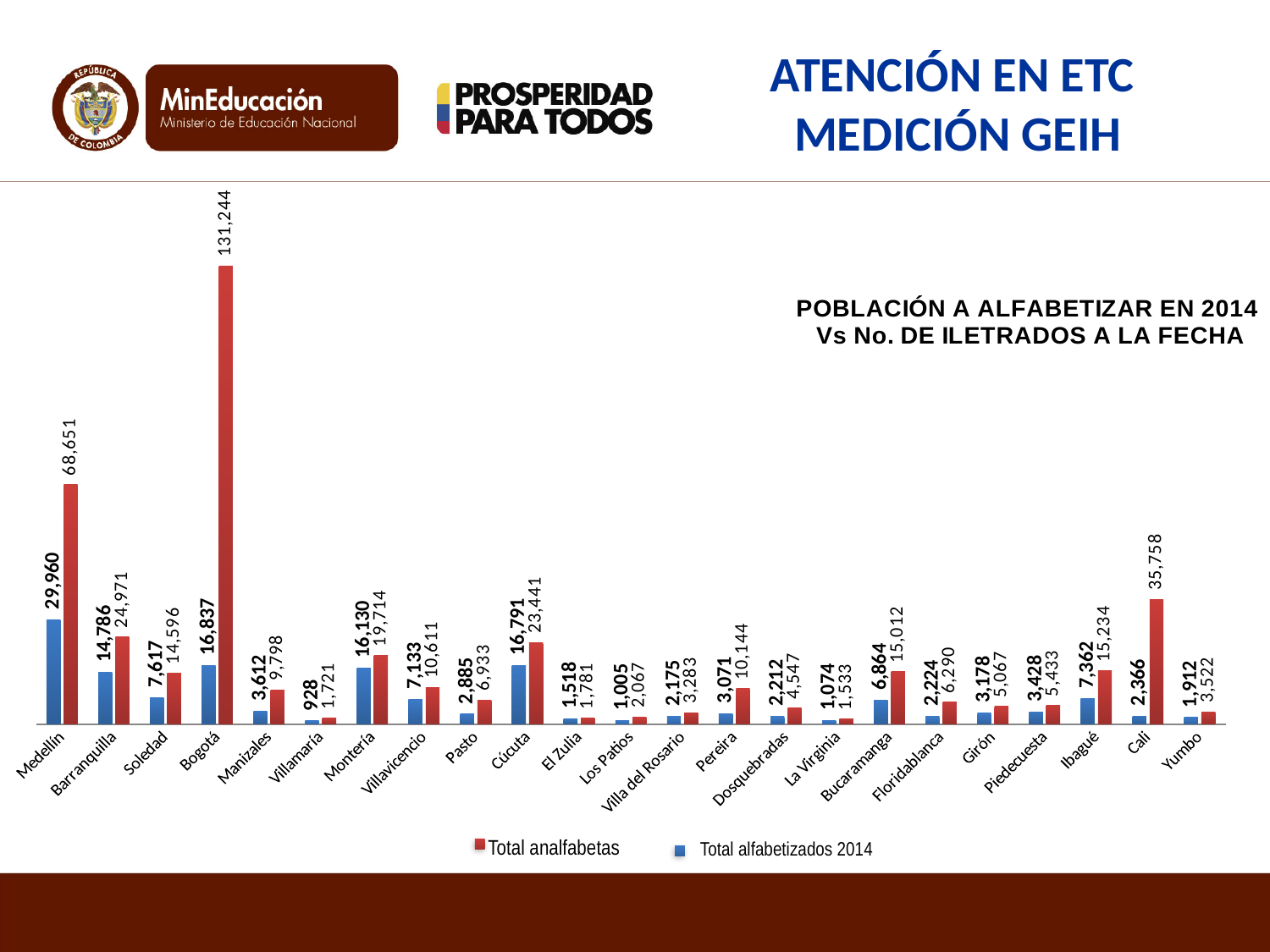
How many series does the legend list? 2 What is the value of Total alfabetizados 2014 for Medellín? 29,960 What is the difference between Total analfabetas and Total alfabetizados 2014 for Cali? 33,392 What is the value of Total analfabetas for Cali? 35,758 Which city has the highest value of Total analfabetas? Bogotá What kind of chart is shown on the slide? Bar chart What is the value of Total alfabetizados 2014 for Cúcuta? 16,791 How many cities are shown on the x axis of the chart? 23 What is the value of Total analfabetas for Bogotá? 131,244 What is the difference between Total analfabetas and Total alfabetizados 2014 for Medellín? 38,691 Which is larger: Total alfabetizados 2014 for Montería or for Bucaramanga? Montería Which city has the lowest value of Total alfabetizados 2014? Villamaría